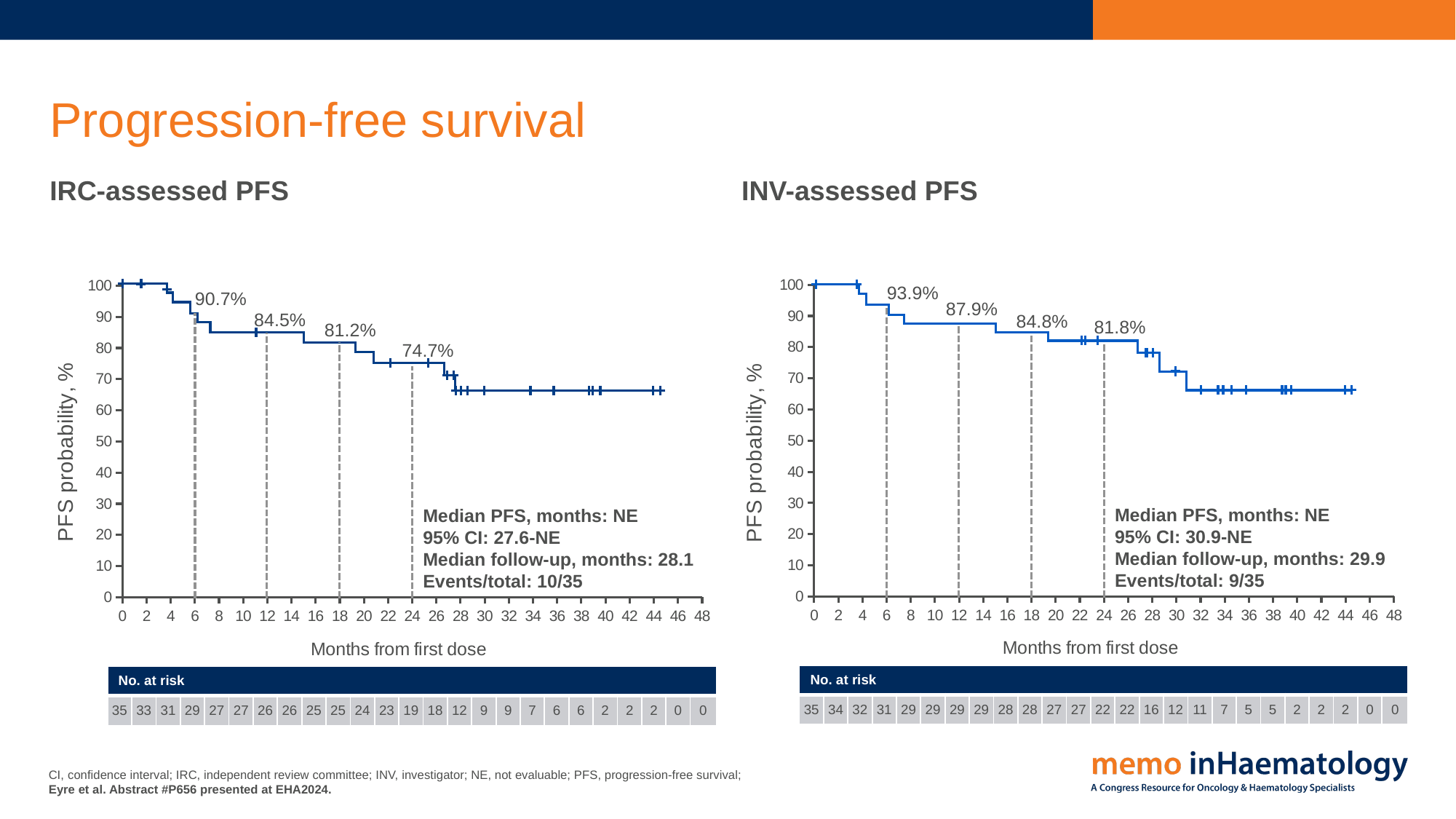
What kind of chart is the IRC-assessed PFS chart? Kaplan-Meier survival curve (line chart) On the INV-assessed PFS chart, does the PFS probability rise or fall as months from first dose increase? fall On the INV-assessed PFS chart, is the PFS probability at 30 months greater or less than 60? greater Which chart shows the higher labelled PFS probability at 24 months, IRC-assessed PFS or INV-assessed PFS? INV-assessed PFS On the IRC-assessed PFS chart, what is the PFS probability labelled at 6 months? 90.7% On the IRC-assessed PFS chart, is the PFS probability at 40 months greater or less than 70? less On the INV-assessed PFS chart, what is the PFS probability labelled at 24 months? 81.8% On the IRC-assessed PFS chart, how many patients are at risk at 24 months according to the No. at risk table? 19 On the INV-assessed PFS chart, how many patients are at risk at 0 months according to the No. at risk table? 35 On the IRC-assessed PFS chart, what is the difference between the labelled PFS probabilities at 6 months and 24 months? 16.0% On the IRC-assessed PFS chart, what is the PFS probability labelled at 18 months? 81.2% On the INV-assessed PFS chart, what is the PFS probability labelled at 12 months? 87.9%